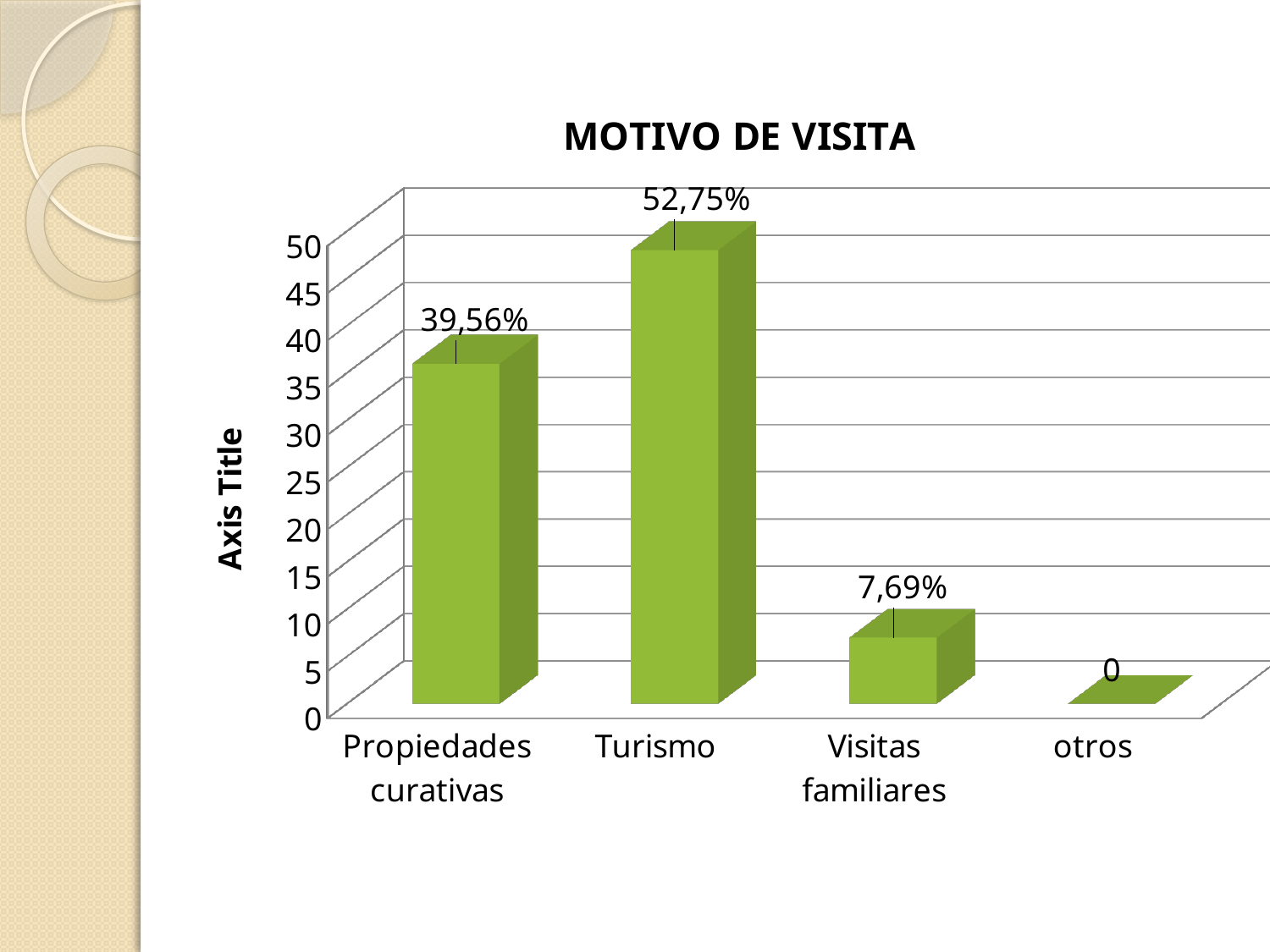
Which category has the highest value? Turismo What is the value for Turismo? 52,75% What kind of chart is this? bar chart What is the value for otros? 0 What is the difference between the values for Turismo and Propiedades curativas? 13,19% What is the value for Visitas familiares? 7,69% Which category has the lowest value? otros What is the value for Propiedades curativas? 39,56% Which is larger, the value for Propiedades curativas or the value for Visitas familiares? Propiedades curativas What is the title of the chart? MOTIVO DE VISITA How many categories are shown on the x axis? 4